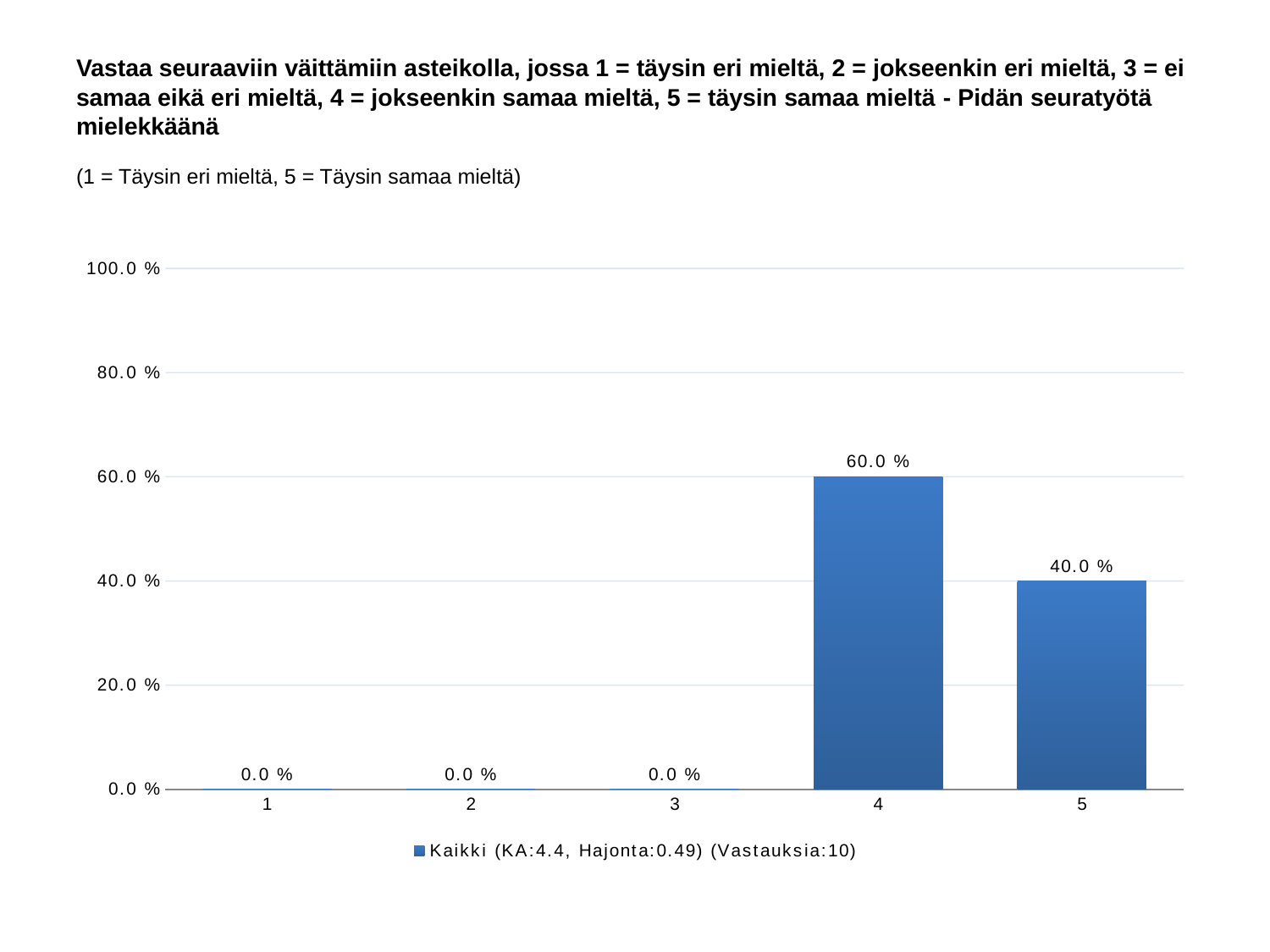
Is the value for category 4 greater or less than 80.0 %? less What is the value for category 5? 40.0 % How many series does the legend list? 1 What is the legend entry for the series? Kaikki (KA:4.4, Hajonta:0.49) (Vastauksia:10) What is the value for category 4? 60.0 % Which is larger, the value for category 4 or the value for category 5? 4 Which category has the highest value? 4 What is the value for category 1? 0.0 % How many categories have a value of 0.0 %? 3 How many categories are shown on the x axis? 5 What kind of chart is shown on the slide? bar chart What is the difference between the values for category 4 and category 5? 20.0 %